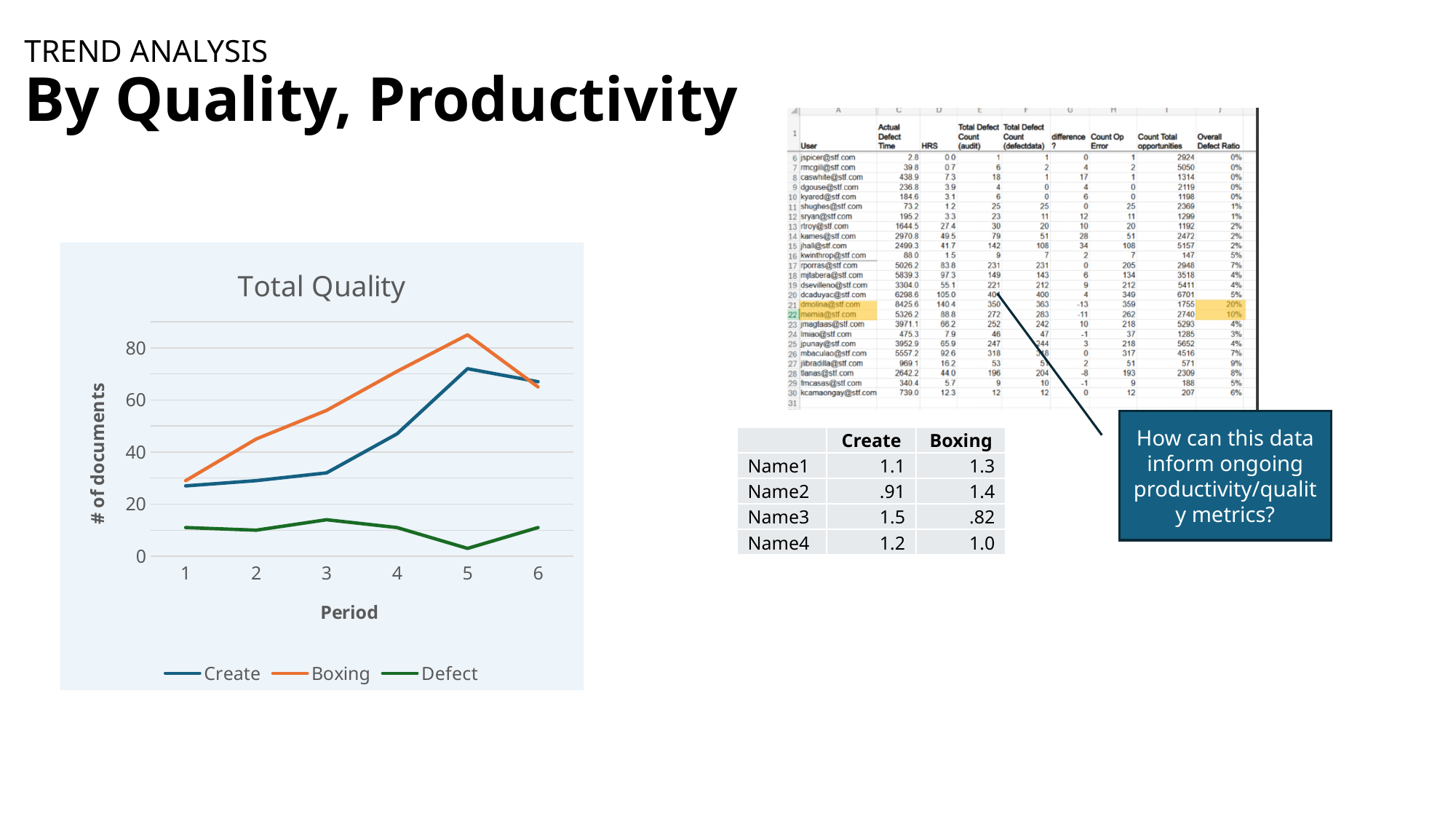
In the "Total Quality" chart, at which period does the Boxing series reach its highest value? 5 How many series does the legend of the "Total Quality" chart list? 3 What is the label on the y axis of the "Total Quality" chart? # of documents What kind of chart is the "Total Quality" chart? line chart How many periods are shown on the x axis of the "Total Quality" chart? 6 In the "Total Quality" chart, is the Boxing value at period 5 greater or less than 80? greater In the "Total Quality" chart, which series has the larger value at period 4, Create or Boxing? Boxing In the "Total Quality" chart, is the Create value at period 1 greater or less than 40? less In the "Total Quality" chart, at which period is the Defect series at its lowest? 5 In the "Total Quality" chart, is the Defect value at period 3 greater or less than 20? less In the "Total Quality" chart, at which period does the Create series reach its highest value? 5 In the "Total Quality" chart, does the Boxing series rise or fall from period 1 to period 5? rise